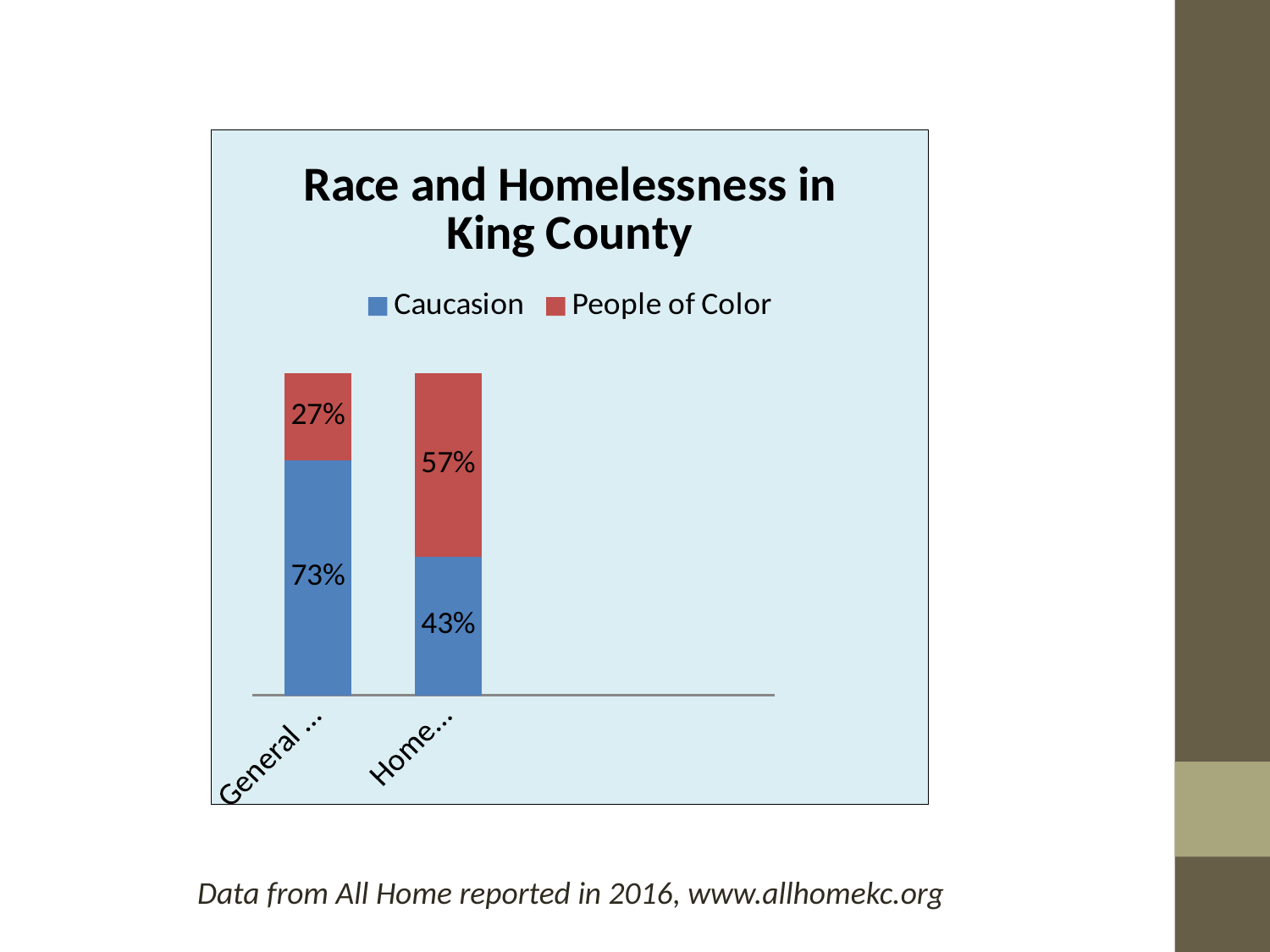
In the right bar (labelled "Home..."), which series has the larger value, Caucasion or People of Color? People of Color What is the Caucasion value for the right bar (labelled "Home...")? 43% What is the People of Color value for the left bar (labelled "General ...")? 27% Which colour represents People of Color in the legend? Red What is the title of the chart? Race and Homelessness in King County What is the difference between the Caucasion value in the left bar and the Caucasion value in the right bar? 30 percentage points What is the Caucasion value for the left bar (labelled "General ...")? 73% What is the total of the two segments in the left bar (labelled "General ...")? 100% What is the People of Color value for the right bar (labelled "Home...")? 57% How many bars (categories) are plotted on the chart? 2 How many series does the legend list? 2 What kind of chart is shown on the slide? Stacked bar chart